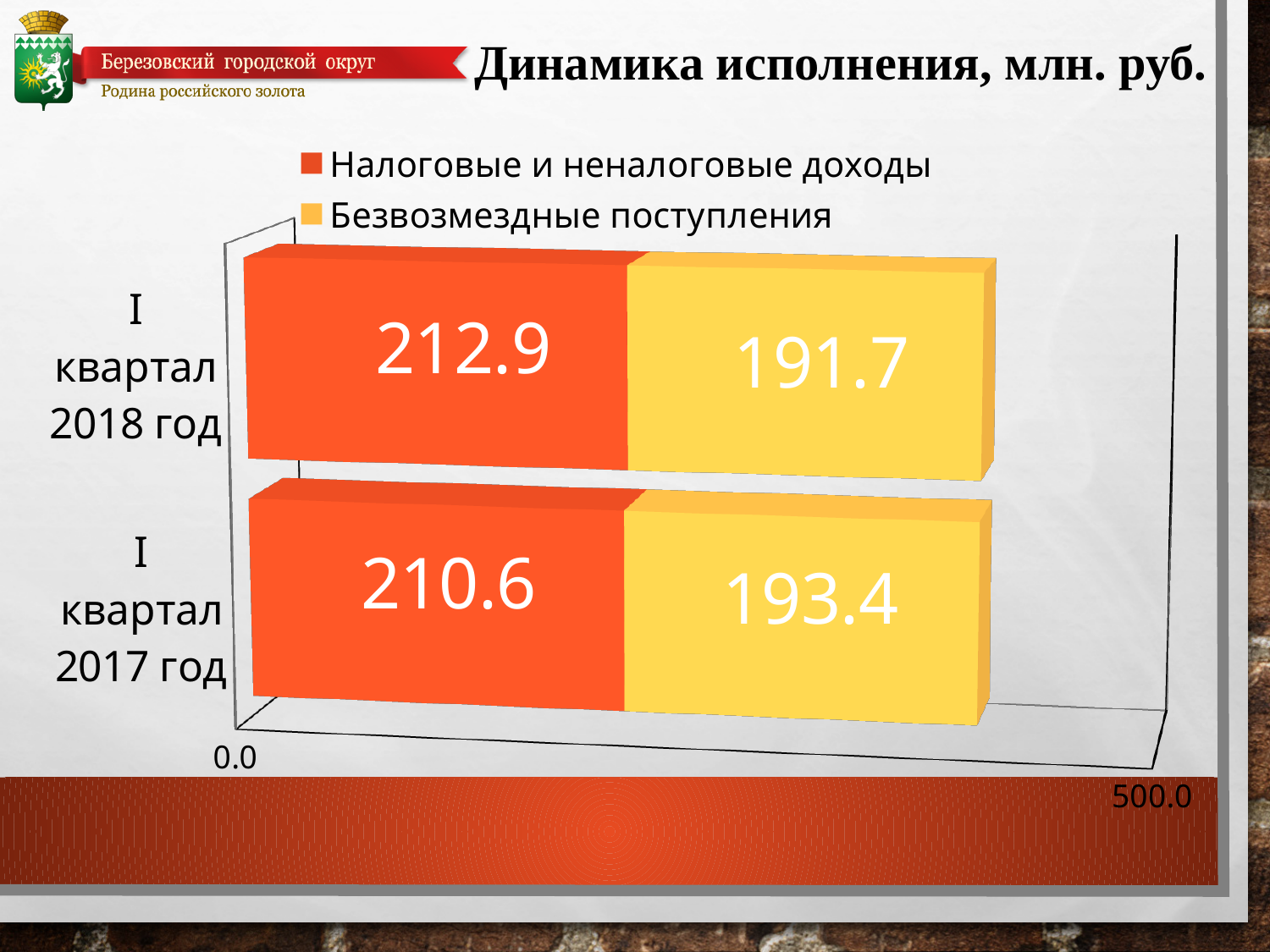
Which is larger for I квартал 2018 год: Налоговые и неналоговые доходы or Безвозмездные поступления? Налоговые и неналоговые доходы What is the difference between Налоговые и неналоговые доходы in I квартал 2018 год and I квартал 2017 год? 2.3 How many series does the legend list? 2 What is the value of Безвозмездные поступления for I квартал 2018 год? 191.7 What is the value of Безвозмездные поступления for I квартал 2017 год? 193.4 What is the total of the stacked bar for I квартал 2018 год? 404.6 What is the value of Налоговые и неналоговые доходы for I квартал 2018 год? 212.9 What is the value of Налоговые и неналоговые доходы for I квартал 2017 год? 210.6 How many categories are shown on the chart? 2 What is the total of the stacked bar for I квартал 2017 год? 404.0 What is the difference between Безвозмездные поступления in I квартал 2017 год and I квартал 2018 год? 1.7 What kind of chart is shown on the slide? Stacked bar chart